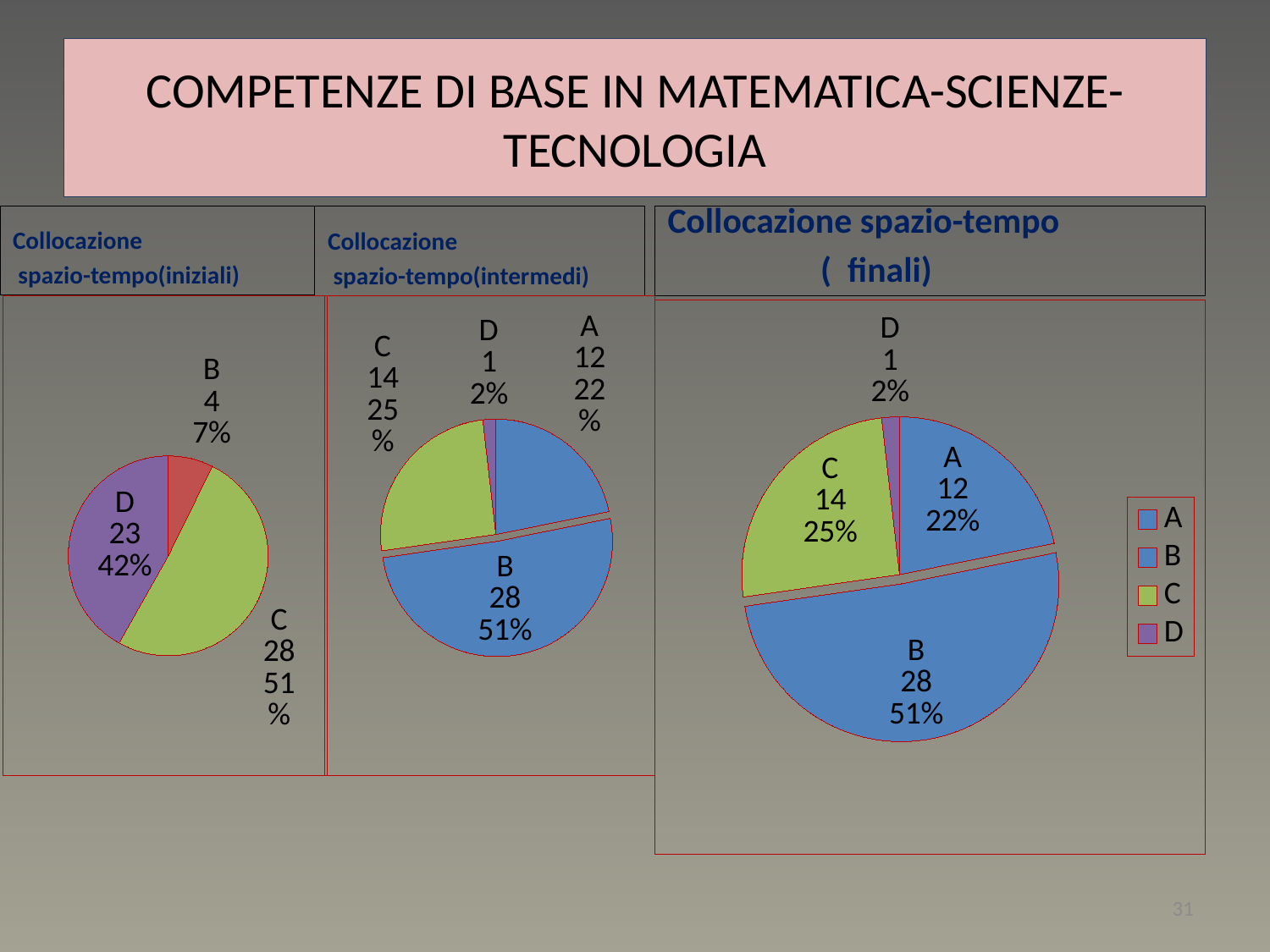
In the 'Collocazione spazio-tempo(iniziali)' pie chart, how many categories are shown? 3 In the 'Collocazione spazio-tempo(iniziali)' pie chart, what is the value for category D? 23 In the 'Collocazione spazio-tempo ( finali)' pie chart, what share of the pie does category C have? 25% How many entries does the legend of the 'Collocazione spazio-tempo ( finali)' chart list? 4 In the 'Collocazione spazio-tempo(intermedi)' pie chart, what is the value for category A? 12 In the 'Collocazione spazio-tempo ( finali)' pie chart, what is the value for category D? 1 In the 'Collocazione spazio-tempo ( finali)' pie chart, which is larger, the value for A or the value for C? C In the 'Collocazione spazio-tempo(iniziali)' pie chart, what share of the pie does category C have? 51% In the 'Collocazione spazio-tempo(iniziali)' pie chart, which category has the smallest slice? B In the 'Collocazione spazio-tempo(intermedi)' pie chart, which category has the largest slice? B What type of chart is used for 'Collocazione spazio-tempo ( finali)'? Pie chart In the 'Collocazione spazio-tempo(intermedi)' pie chart, what is the difference between the values for B and C? 14